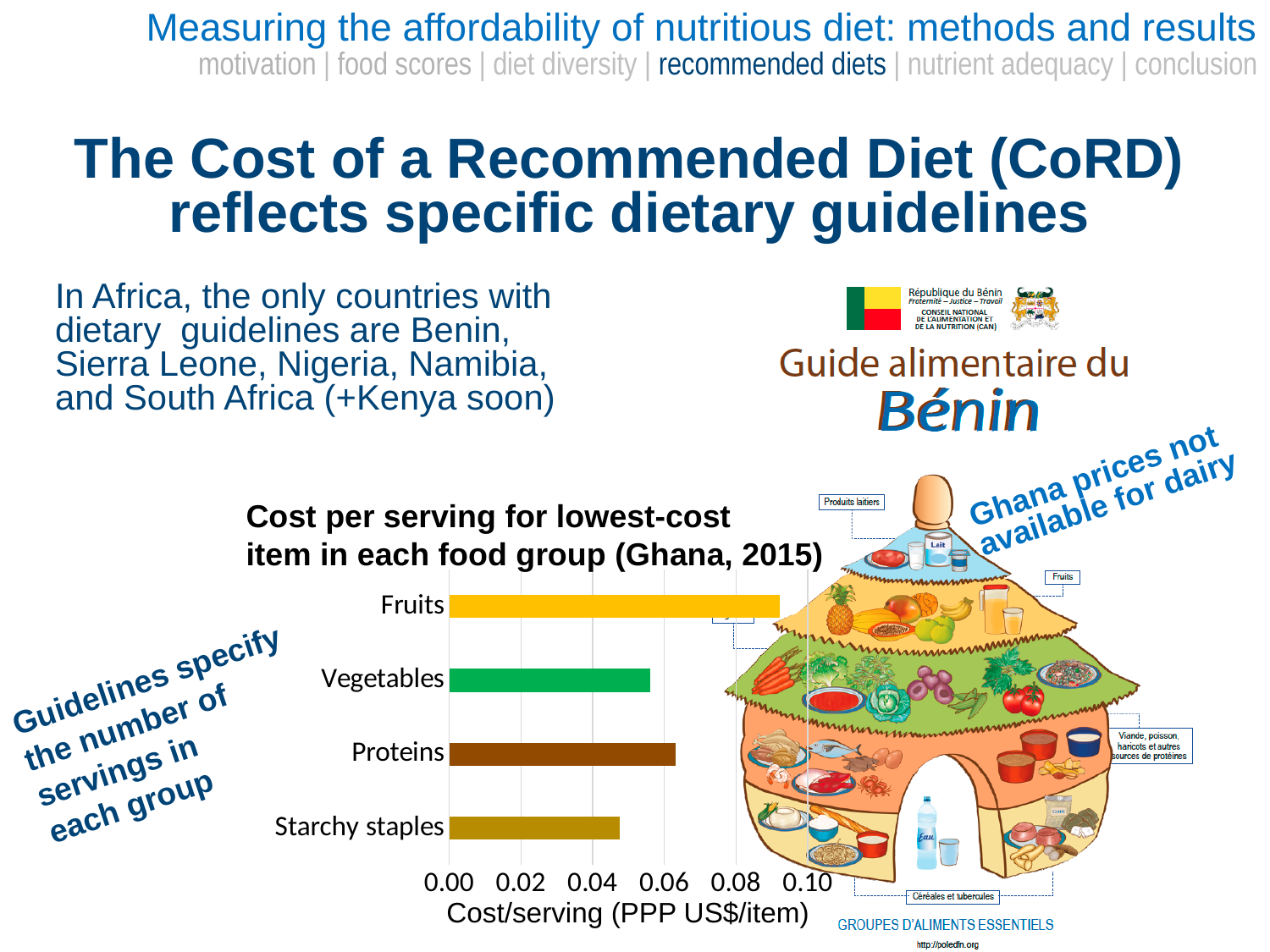
Which food group has the highest cost per serving in the chart? Fruits Is the cost per serving for Vegetables greater or less than 0.04? greater What is the title of the chart? Cost per serving for lowest-cost item in each food group (Ghana, 2015) Which has a higher cost per serving, Vegetables or Starchy staples? Vegetables Which has a higher cost per serving, Fruits or Proteins? Fruits How many food groups are plotted in the chart? 4 Is the cost per serving for Starchy staples greater or less than 0.06? less What kind of chart is shown on the slide? bar chart Is the cost per serving for Fruits greater or less than 0.08? greater What is the label of the horizontal axis of the chart? Cost/serving (PPP US$/item) Which food group has the lowest cost per serving in the chart? Starchy staples